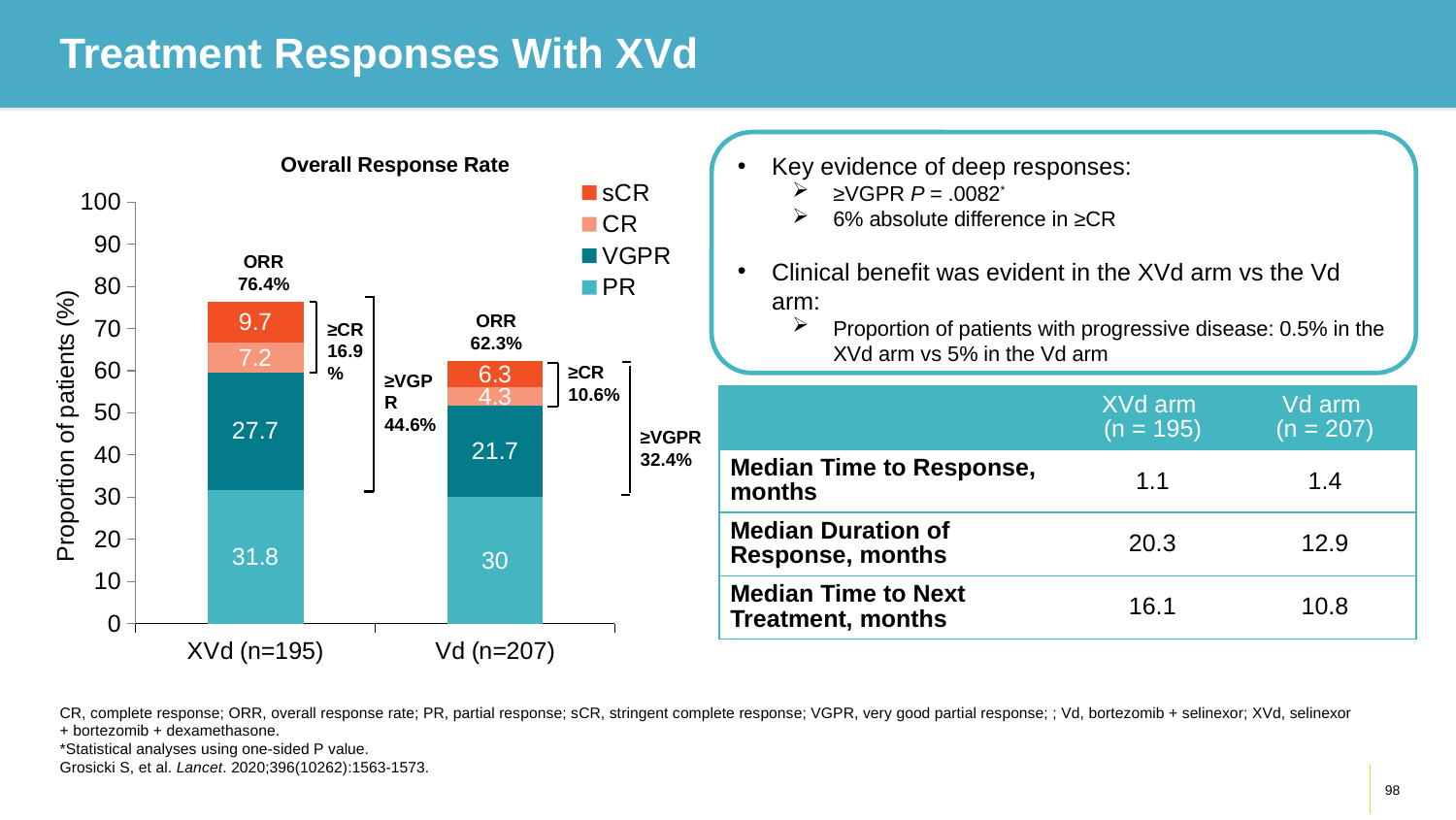
What ORR is labelled above the Vd (n=207) bar? 62.3% What is the label of the y axis of the Overall Response Rate chart? Proportion of patients (%) What is the difference between the VGPR values of the XVd and Vd bars? 6 What is the sCR value for the XVd (n=195) bar? 9.7 What is the CR value for the Vd (n=207) bar? 4.3 Which arm has the higher ORR, XVd or Vd? XVd What is the VGPR value for the Vd (n=207) bar? 21.7 What is the PR value for the XVd (n=195) bar? 31.8 How many series does the legend of the Overall Response Rate chart list? 4 What type of chart is shown under the title "Overall Response Rate"? Stacked bar chart How many treatment arms (categories) are plotted on the x axis of the Overall Response Rate chart? 2 Which segment is the largest in the XVd (n=195) bar? PR